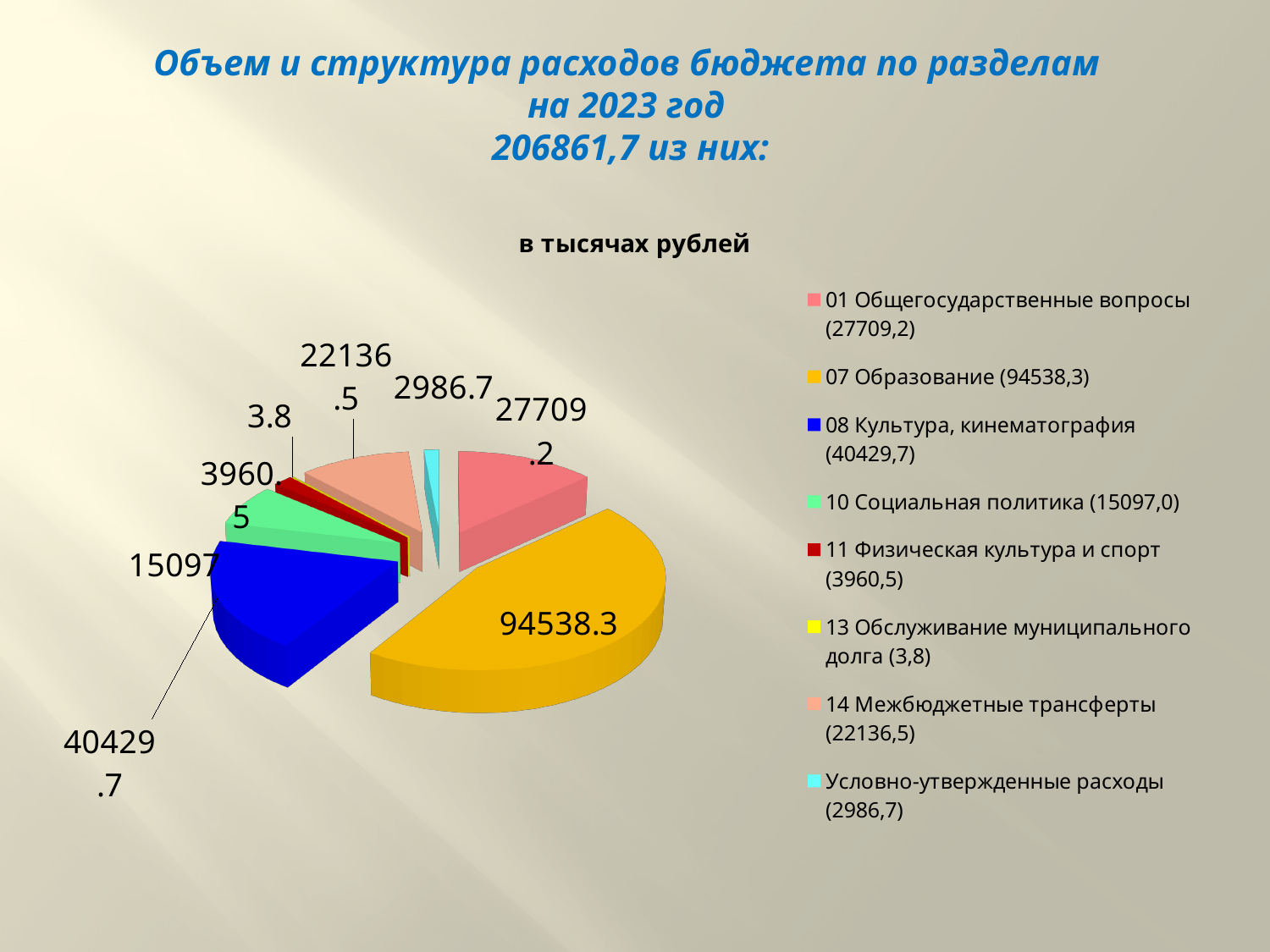
What type of chart is shown on the slide? pie chart Which category has the smallest slice of the pie? 13 Обслуживание муниципального долга Which category has the largest slice of the pie? 07 Образование What is the value for 07 Образование? 94538.3 In what units are the values on the chart expressed, according to the chart subtitle? в тысячах рублей What is the value for 13 Обслуживание муниципального долга? 3.8 What is the value for 08 Культура, кинематография? 40429.7 How many slices does the pie chart have? 8 What is the difference between the values for 01 Общегосударственные вопросы and 14 Межбюджетные трансферты? 5572.7 What is the value for 14 Межбюджетные трансферты? 22136.5 Which is larger: the value for 10 Социальная политика or the value for 11 Физическая культура и спорт? 10 Социальная политика What is the difference between the values for 07 Образование and 08 Культура, кинематография? 54108.6